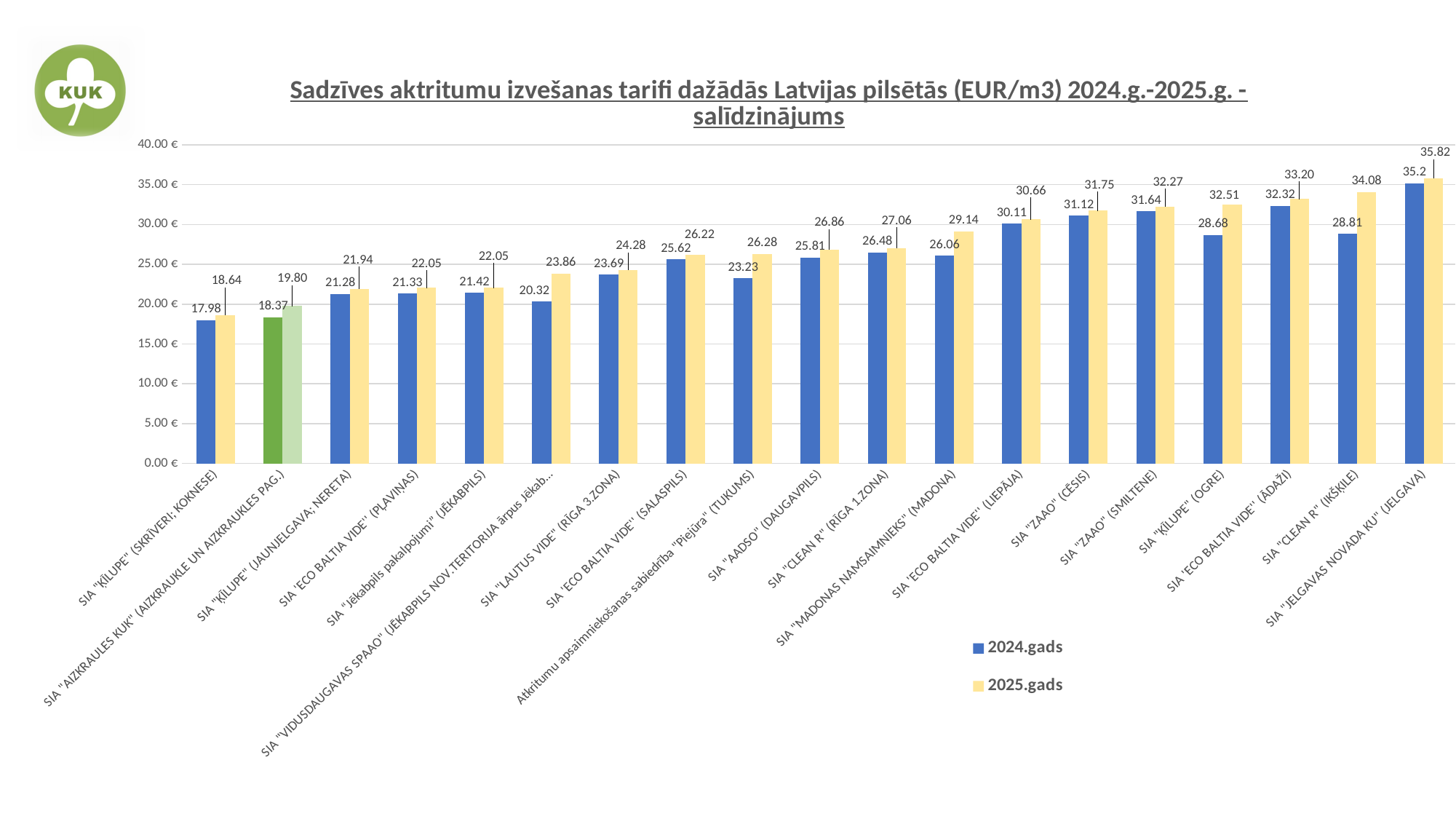
What is the difference between the 2025.gads and 2024.gads values for SIA "ĶILUPE" (OGRE)? 3.83 What kind of chart is shown on the slide? bar chart Which category has the lowest 2024.gads value? SIA "ĶILUPE" (SKRĪVERI; KOKNESE) Which is larger: the 2024.gads value for SIA "ECO BALTIA VIDE" (ĀDAŽI) or the 2024.gads value for SIA "ZAAO" (SMILTENE)? SIA "ECO BALTIA VIDE" (ĀDAŽI) How many series does the legend list? 2 What is the 2025.gads value for SIA "ZAAO" (CĒSIS)? 31.75 What is the 2025.gads value for SIA "AIZKRAUKLES KUK" (AIZKRAUKLE UN AIZKRAUKLES PAG.)? 19.80 Which category is shown with green bars instead of blue and yellow? SIA "AIZKRAUKLES KUK" (AIZKRAUKLE UN AIZKRAUKLES PAG.) Which category has the highest 2025.gads value? SIA "JELGAVAS NOVADA KU" (JELGAVA) What is the 2024.gads value for SIA "CLEAN R" (IKŠĶILE)? 28.81 Is the 2025.gads value for SIA "MADONAS NAMSAIMNIEKS" (MADONA) greater or less than 25.00 €? greater How many categories are shown on the x axis? 19